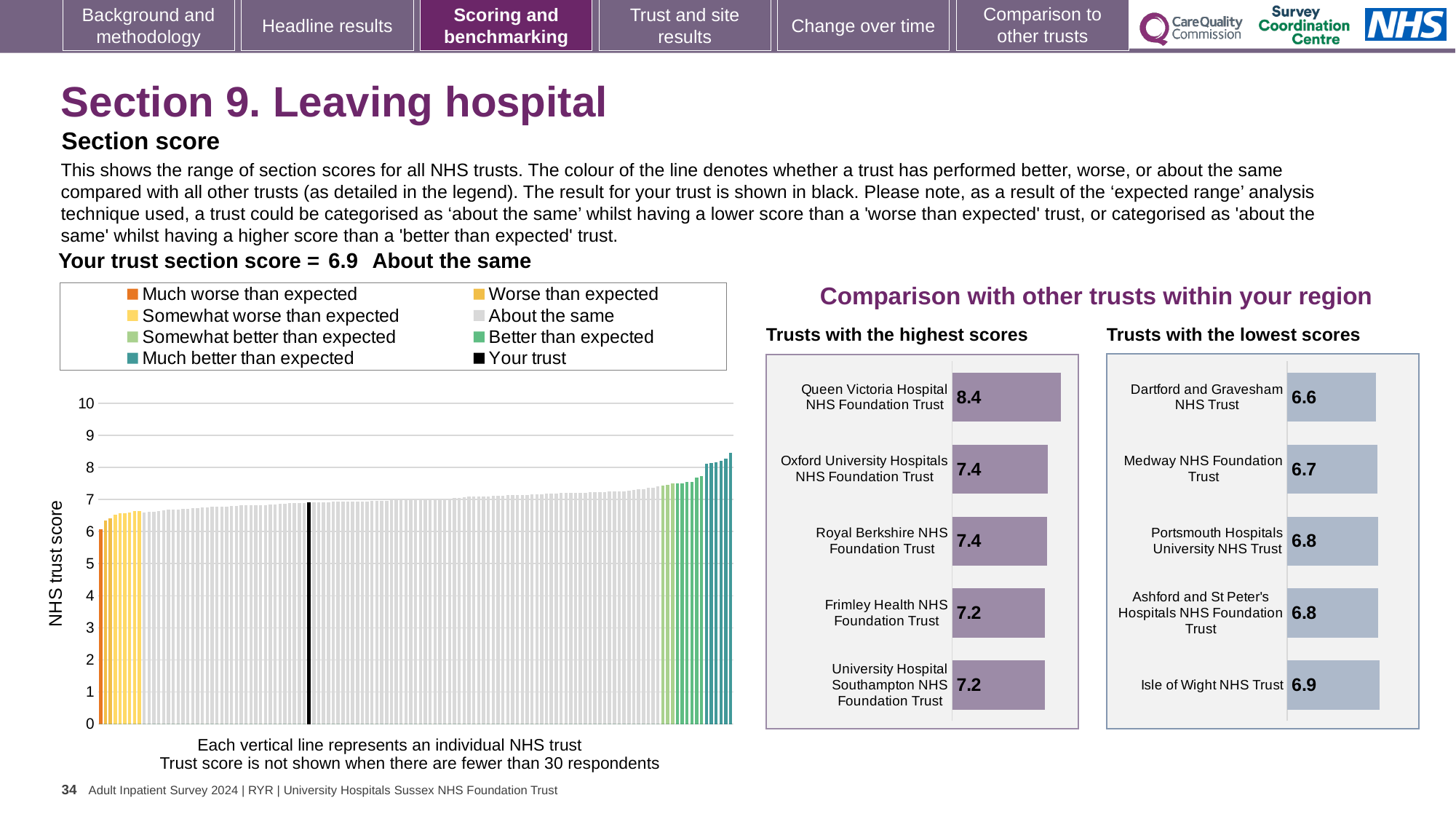
How many entries does the legend above the large 'NHS trust score' chart list? 8 How many trusts are shown in the 'Trusts with the lowest scores' chart? 5 How many trusts are shown in the 'Trusts with the highest scores' chart? 5 In the large 'NHS trust score' chart on the left, do the values rise or fall from left to right? Rise In the large 'NHS trust score' chart on the left, what is the section score for your trust (the black bar)? 6.9 In the 'Trusts with the lowest scores' chart, which has the larger score: Medway NHS Foundation Trust or Isle of Wight NHS Trust? Isle of Wight NHS Trust In the 'Trusts with the highest scores' chart, which trust has the highest score? Queen Victoria Hospital NHS Foundation Trust What kind of chart is the large 'NHS trust score' chart on the left of the slide? Bar chart In the 'Trusts with the highest scores' chart, what is the difference between the scores of Queen Victoria Hospital NHS Foundation Trust and Frimley Health NHS Foundation Trust? 1.2 In the 'Trusts with the lowest scores' chart, which trust has the lowest score? Dartford and Gravesham NHS Trust In the 'Trusts with the lowest scores' chart, what is the score for Dartford and Gravesham NHS Trust? 6.6 In the 'Trusts with the highest scores' chart, what is the score for Queen Victoria Hospital NHS Foundation Trust? 8.4